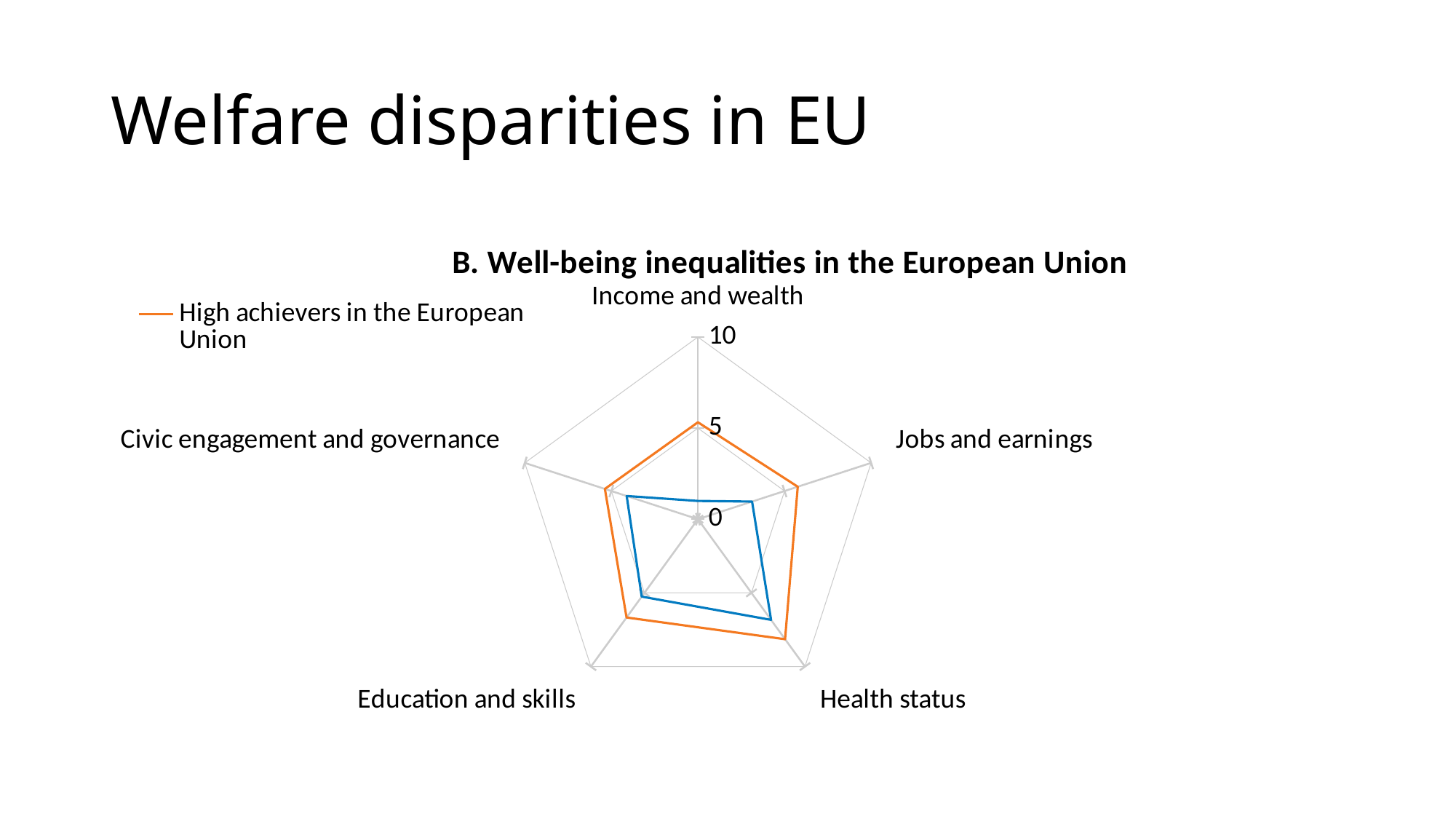
How many categories (axes) does the radar chart have? 5 Is the value for Jobs and earnings on the blue line greater or less than 5? less On the blue line, which category has the lowest value? Income and wealth What is the title of the chart? B. Well-being inequalities in the European Union Is the value for Income and wealth on the blue line greater or less than 5? less For Income and wealth, which line has the larger value, the orange 'High achievers in the European Union' line or the blue line? The orange line Is the value for Health status on the orange 'High achievers in the European Union' line greater or less than 5? greater Which series does the legend name? High achievers in the European Union On the orange 'High achievers in the European Union' line, which category has the highest value? Health status What kind of chart is shown on the slide? Radar chart What is the maximum value shown on the radar chart's axis scale? 10 How many series does the legend list? 1